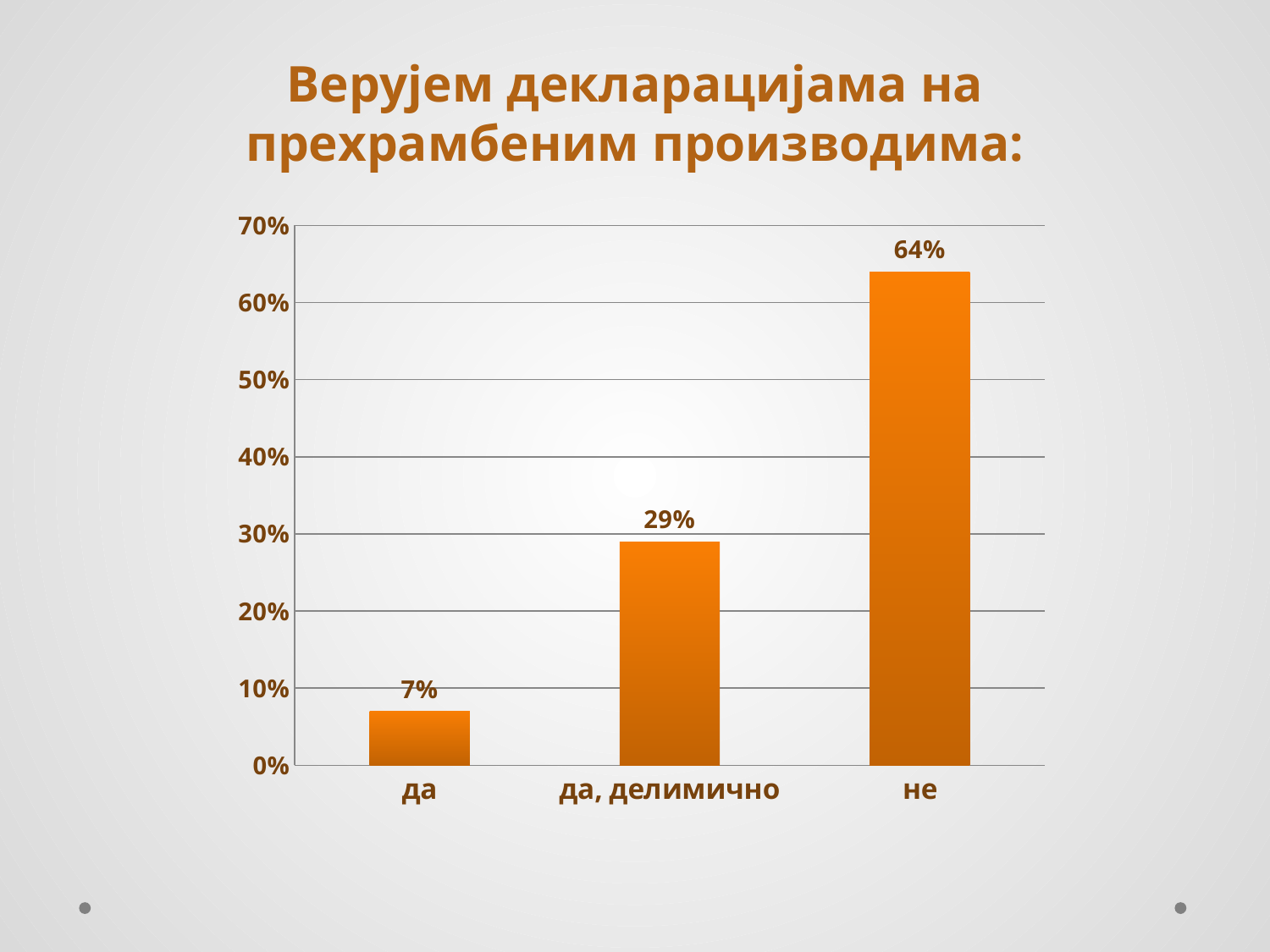
What is the difference between the values for "да, делимично" and "да"? 22% What is the value for "да, делимично"? 29% Which category has the lowest value? да What is the value for "да"? 7% Which category has the highest value? не What is the value for "не"? 64% Which is larger, the value for "да" or the value for "да, делимично"? да, делимично Do the values rise or fall from left to right along the x axis? rise What kind of chart is shown on the slide? bar chart What is the difference between the values for "не" and "да, делимично"? 35% How many categories are shown on the x axis? 3 Is the value for "не" greater or less than 60%? greater